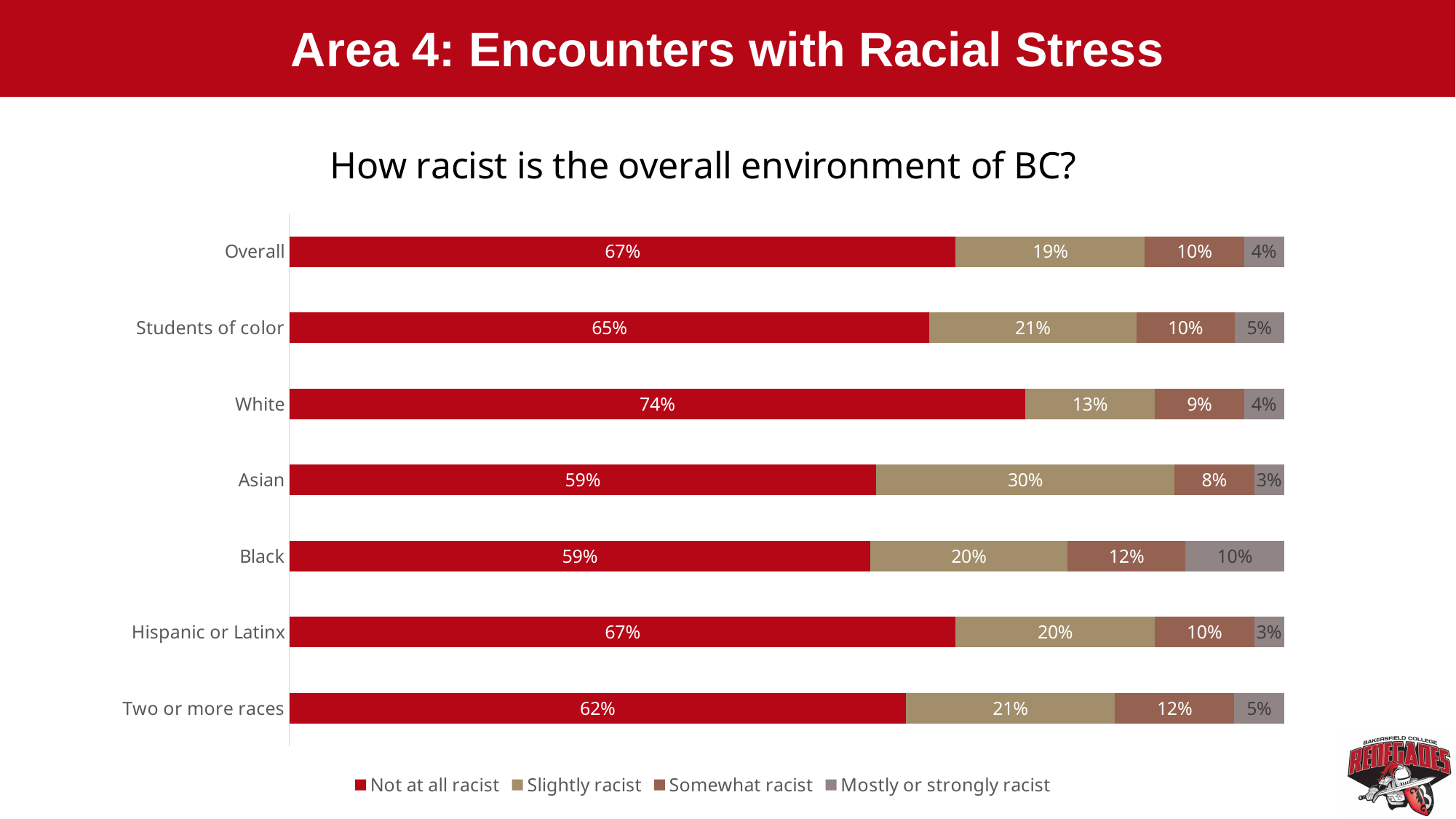
How many groups (categories) are shown on the chart? 7 What percentage of White respondents rated the overall environment of BC as "Not at all racist"? 74% What kind of chart is shown on the slide? Stacked bar chart Which is larger: the "Somewhat racist" percentage for Black respondents or for Hispanic or Latinx respondents? Black What is the title of the chart? How racist is the overall environment of BC? What is the difference between the "Not at all racist" percentages for White and Asian respondents? 15% Which group has the highest "Mostly or strongly racist" percentage? Black Which group has the lowest "Slightly racist" percentage? White How many series does the legend list? 4 Which group has the highest "Not at all racist" percentage? White What percentage of Asian respondents rated the environment as "Slightly racist"? 30% What percentage of Black respondents rated the environment as "Mostly or strongly racist"? 10%